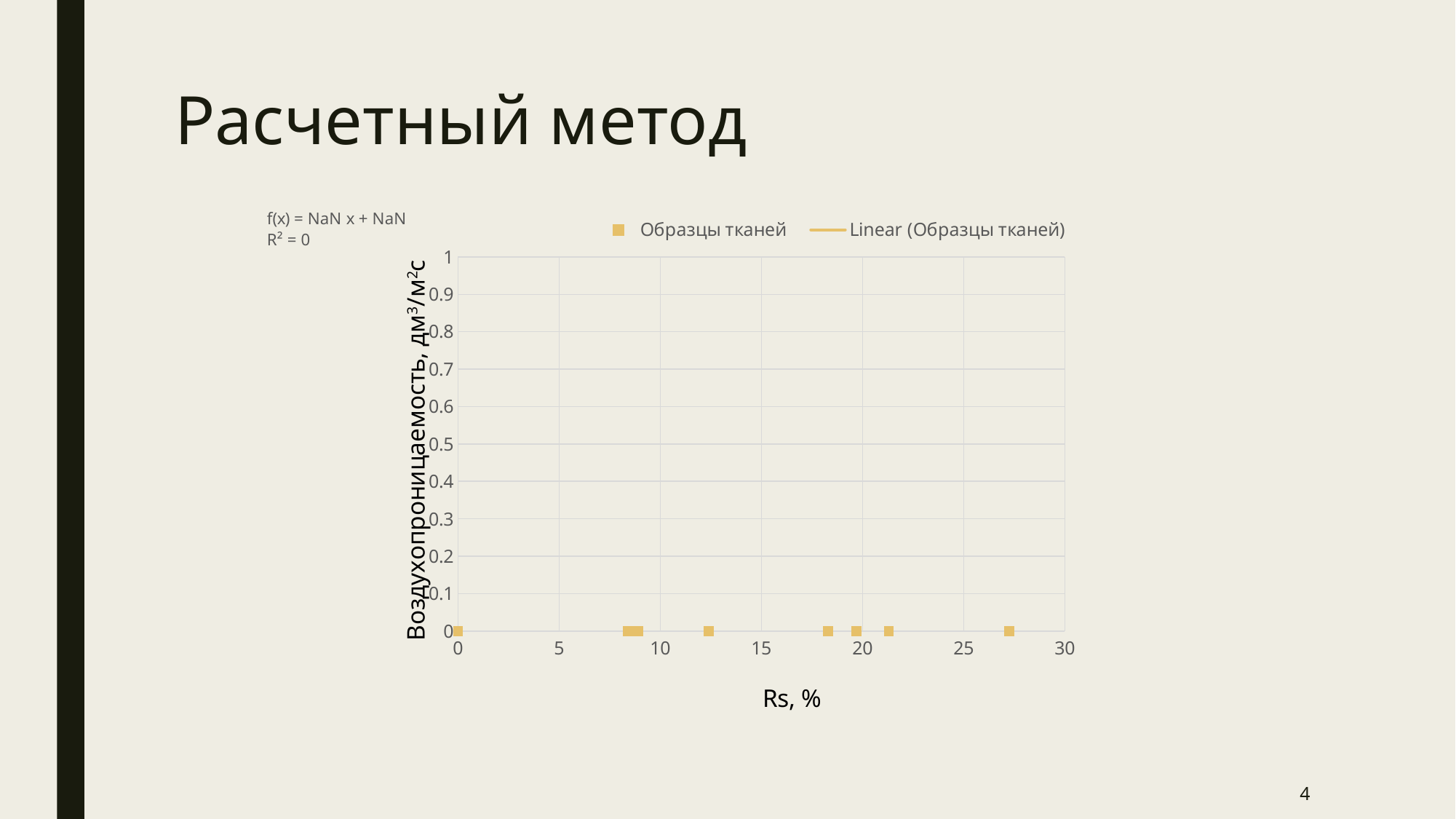
What is the label of the x axis of the chart? Rs, % How many entries does the chart legend list? 2 What kind of chart is shown on the slide? scatter chart What is the Воздухопроницаемость value of the data point plotted at Rs = 0? 0 What is the highest tick value shown on the y axis of the chart? 1 Do the plotted Воздухопроницаемость values rise, fall, or stay flat as Rs increases along the x axis? stay flat Is the Rs value of the rightmost data point greater or less than 25? greater What is the title of the slide containing the chart? Расчетный метод What R² value is printed for the trendline on the chart? R² = 0 What is the highest tick value shown on the x axis of the chart? 30 Is the Rs value of the leftmost data point after Rs = 0 greater or less than 10? less